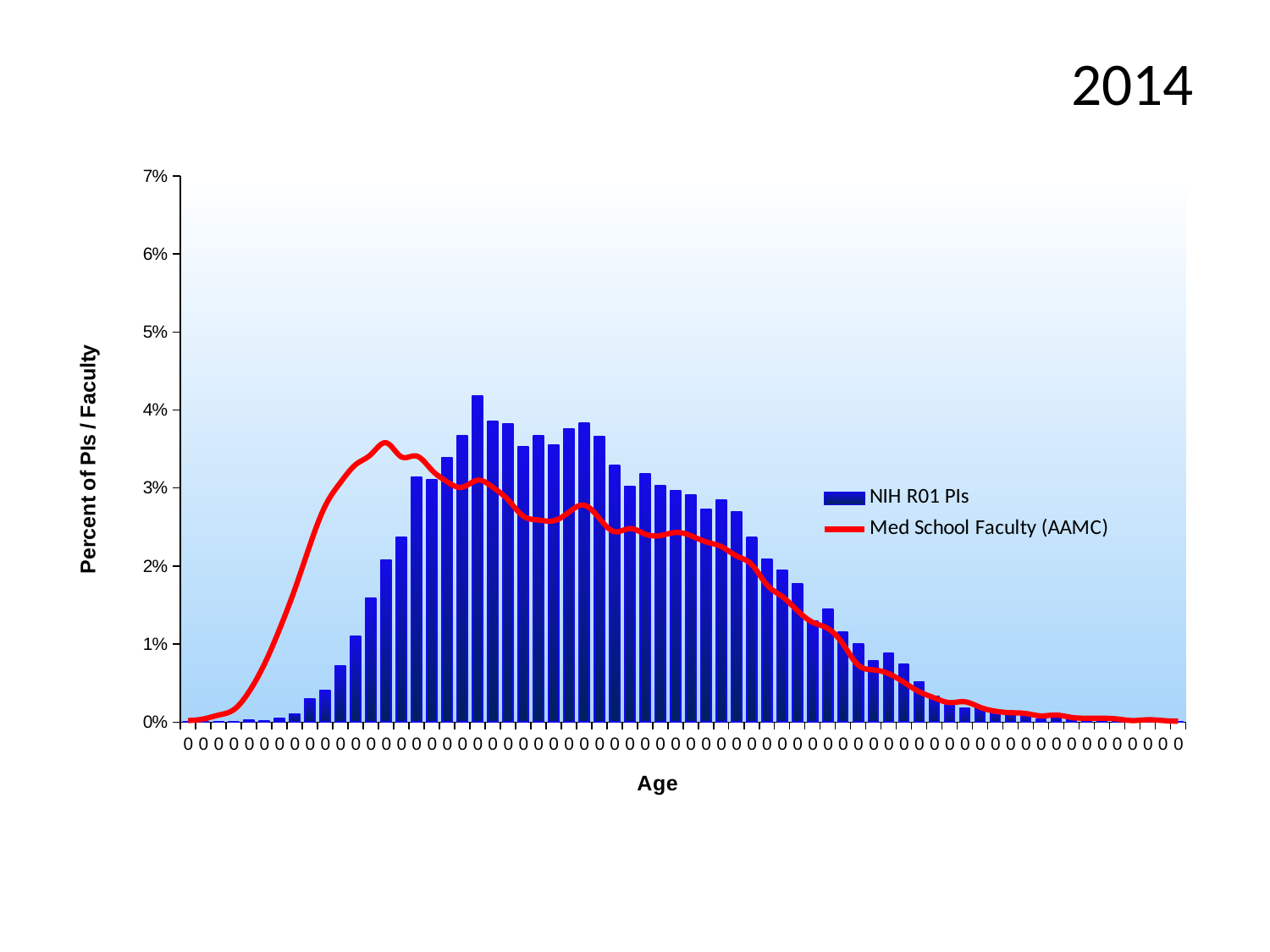
Which series rises first moving from left to right along the Age axis? Med School Faculty (AAMC) Is the peak of the Med School Faculty (AAMC) line greater or less than 4%? less What are the two series named in the legend? NIH R01 PIs and Med School Faculty (AAMC) How many series does the legend list? 2 Which series reaches the higher peak value, NIH R01 PIs or Med School Faculty (AAMC)? NIH R01 PIs What kind of chart is shown on the slide? bar chart with a line series Toward the right end of the Age axis, do the values of both series rise or fall? fall Is the peak of the Med School Faculty (AAMC) line greater or less than 3%? greater Is the tallest NIH R01 PIs bar greater or less than 5%? less What year is shown as the title of the slide? 2014